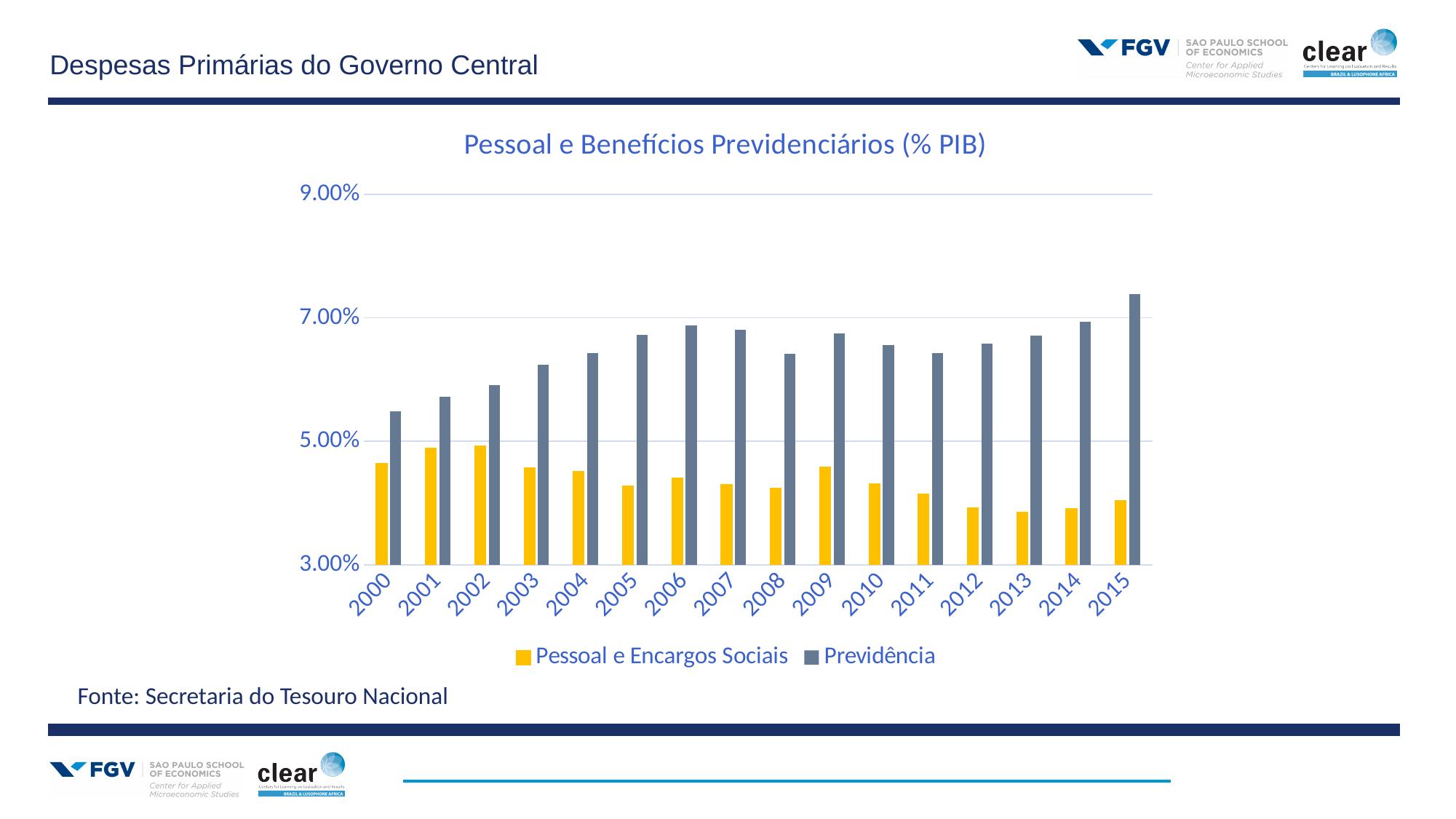
What kind of chart is shown on the slide? Bar chart How many years are shown on the x axis? 16 In which year is the Previdência value lowest? 2000 How many series does the legend list? 2 Is the Previdência value for 2000 greater or less than 5.00%? greater Does the Previdência series generally rise or fall from 2000 to 2015? Rise In which year is the Pessoal e Encargos Sociais value highest? 2002 Is the Previdência value for 2015 greater or less than 7.00%? greater What is the title of the chart? Pessoal e Benefícios Previdenciários (% PIB) Which is larger, the Previdência value for 2015 or for 2000? 2015 In which year is the Previdência value highest? 2015 Is the Pessoal e Encargos Sociais value for 2002 greater or less than 5.00%? less